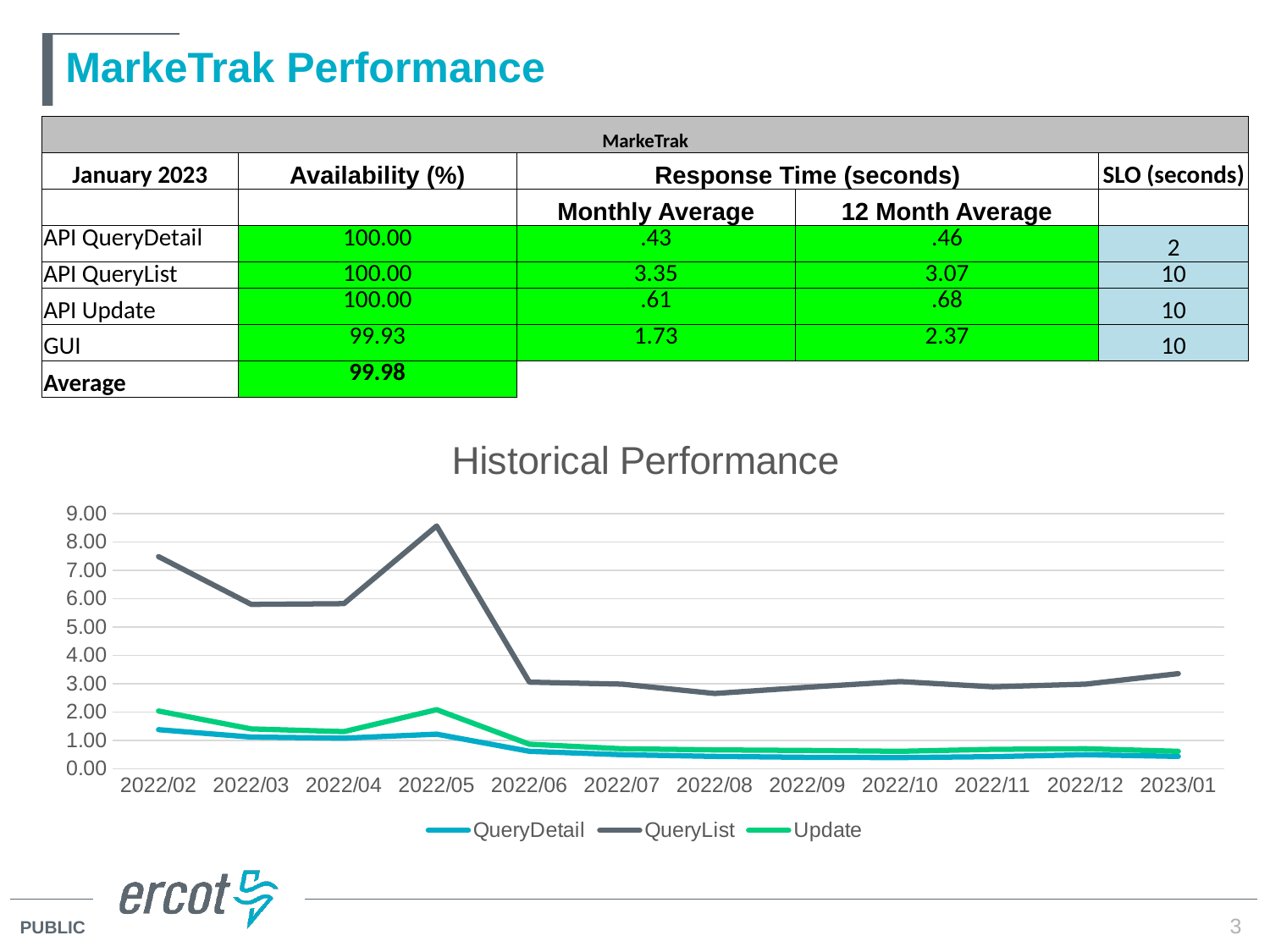
How many months are plotted along the x axis of the Historical Performance chart? 12 In the Historical Performance chart, which is larger at 2022/02, the Update value or the QueryDetail value? Update How many series does the legend of the Historical Performance chart list? 3 In the Historical Performance chart, is the QueryList value for 2022/02 greater or less than 7.00? greater In the Historical Performance chart, is the QueryList value for 2022/05 greater or less than 8.00? greater In the Historical Performance chart, in which month is the QueryList line at its lowest? 2022/08 In the Historical Performance chart, which series has the highest values across the whole period? QueryList In the Historical Performance chart, does the QueryList line rise or fall between 2022/05 and 2022/06? fall What kind of chart is the Historical Performance chart? line chart What is the title of the line chart on the slide? Historical Performance In the Historical Performance chart, is the QueryDetail value for 2022/02 greater or less than 1.00? greater In the Historical Performance chart, in which month does the QueryList line reach its highest value? 2022/05